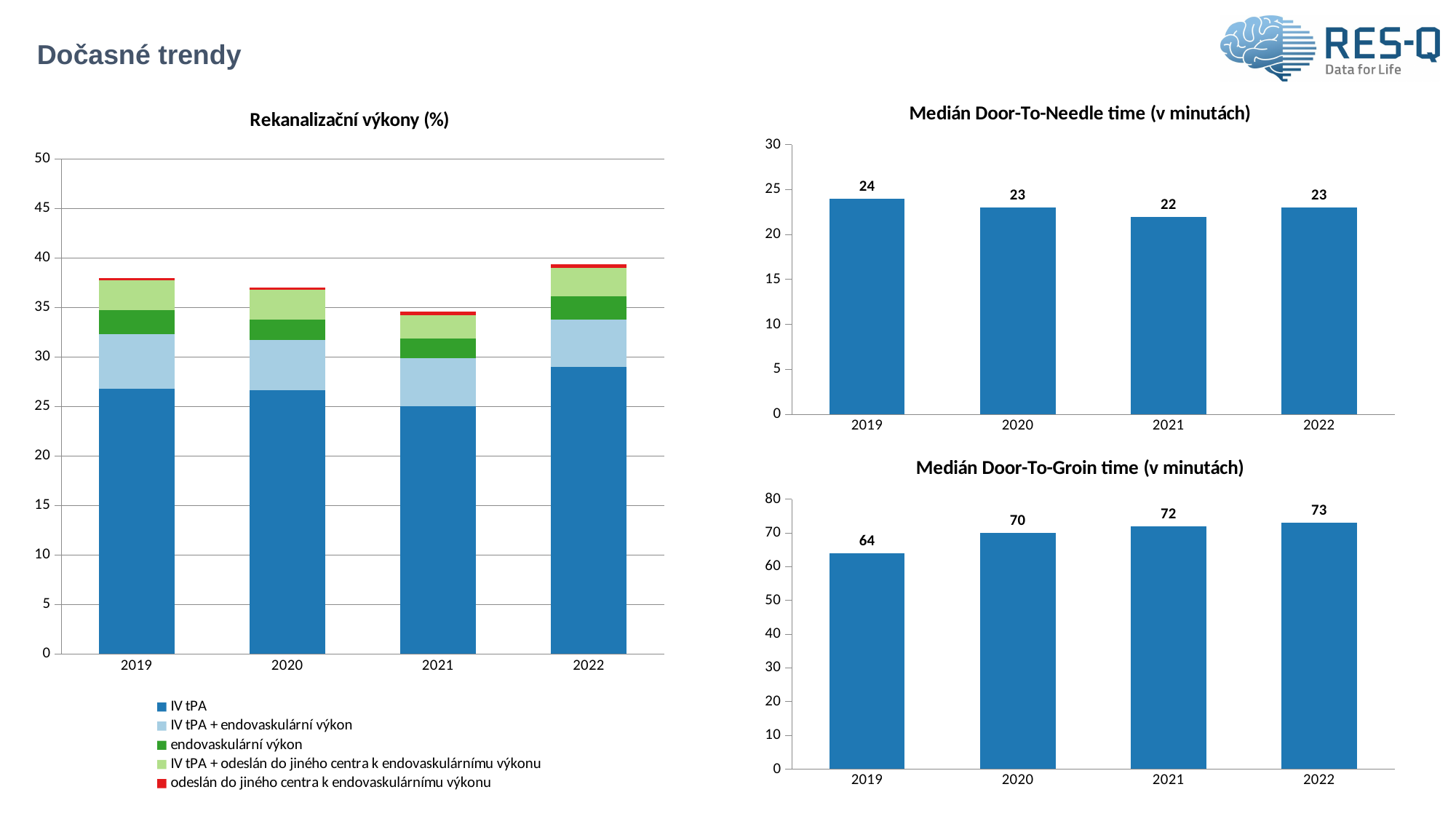
In the Rekanalizační výkony (%) chart, which legend entry is shown in red? odeslán do jiného centra k endovaskulárnímu výkonu In the Medián Door-To-Groin time chart, what is the value for 2019? 64 What kind of chart is the Rekanalizační výkony (%) chart? stacked bar chart In the Medián Door-To-Groin time chart, what is the difference between the values for 2022 and 2019? 9 In the Medián Door-To-Needle time chart, what is the value for 2019? 24 In the Rekanalizační výkony (%) chart, how many years are shown on the x axis? 4 In the Rekanalizační výkony (%) chart, how many series does the legend list? 5 In the Medián Door-To-Needle time chart, which year has the lowest value? 2021 In the Medián Door-To-Needle time chart, which year has the larger value, 2019 or 2021? 2019 In the Medián Door-To-Groin time chart, which year has the highest value? 2022 In the Rekanalizační výkony (%) chart, is the total height of the 2022 stacked bar greater or less than 35? greater In the Medián Door-To-Groin time chart, do the values rise or fall from 2019 to 2022? rise